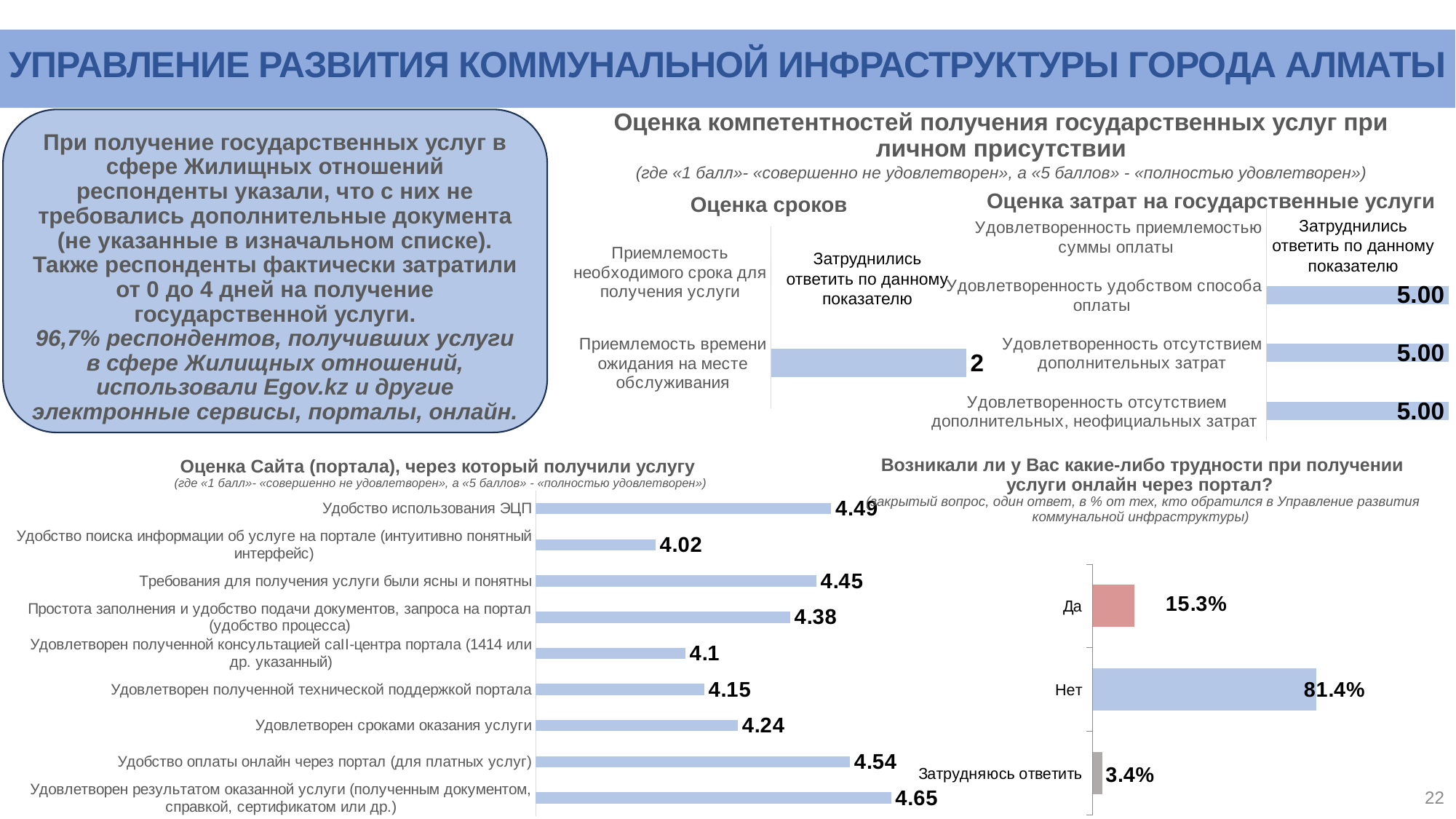
What type of chart is 'Возникали ли у Вас какие-либо трудности при получении услуги онлайн через портал?'? Bar chart In the chart 'Возникали ли у Вас какие-либо трудности при получении услуги онлайн через портал?', what percentage answered 'Нет'? 81.4% In the chart 'Возникали ли у Вас какие-либо трудности при получении услуги онлайн через портал?', what is the difference between 'Да' and 'Затрудняюсь ответить'? 11.9% In the chart 'Оценка затрат на государственные услуги', what is the value for 'Удовлетворенность отсутствием дополнительных затрат'? 5.00 In the chart 'Оценка затрат на государственные услуги', which category is marked 'Затруднились ответить по данному показателю'? Удовлетворенность приемлемостью суммы оплаты In the chart 'Оценка Сайта (портала), через который получили услугу', what is the difference between the values for 'Удобство оплаты онлайн через портал (для платных услуг)' and 'Удовлетворен полученной технической поддержкой портала'? 0.39 In the chart 'Оценка Сайта (портала), через который получили услугу', which category has the lowest value? Удобство поиска информации об услуге на портале (интуитивно понятный интерфейс) In the chart 'Оценка Сайта (портала), через который получили услугу', what is the value for 'Удобство использования ЭЦП'? 4.49 In the chart 'Оценка Сайта (портала), через который получили услугу', which is larger: 'Требования для получения услуги были ясны и понятны' or 'Простота заполнения и удобство подачи документов, запроса на портал (удобство процесса)'? Требования для получения услуги были ясны и понятны In the chart 'Оценка Сайта (портала), через который получили услугу', which category has the highest value? Удовлетворен результатом оказанной услуги (полученным документом, справкой, сертификатом или др.) In the chart 'Оценка сроков', what is the value for 'Приемлемость времени ожидания на месте обслуживания'? 2 In the chart 'Оценка Сайта (портала), через который получили услугу', how many categories are plotted? 9